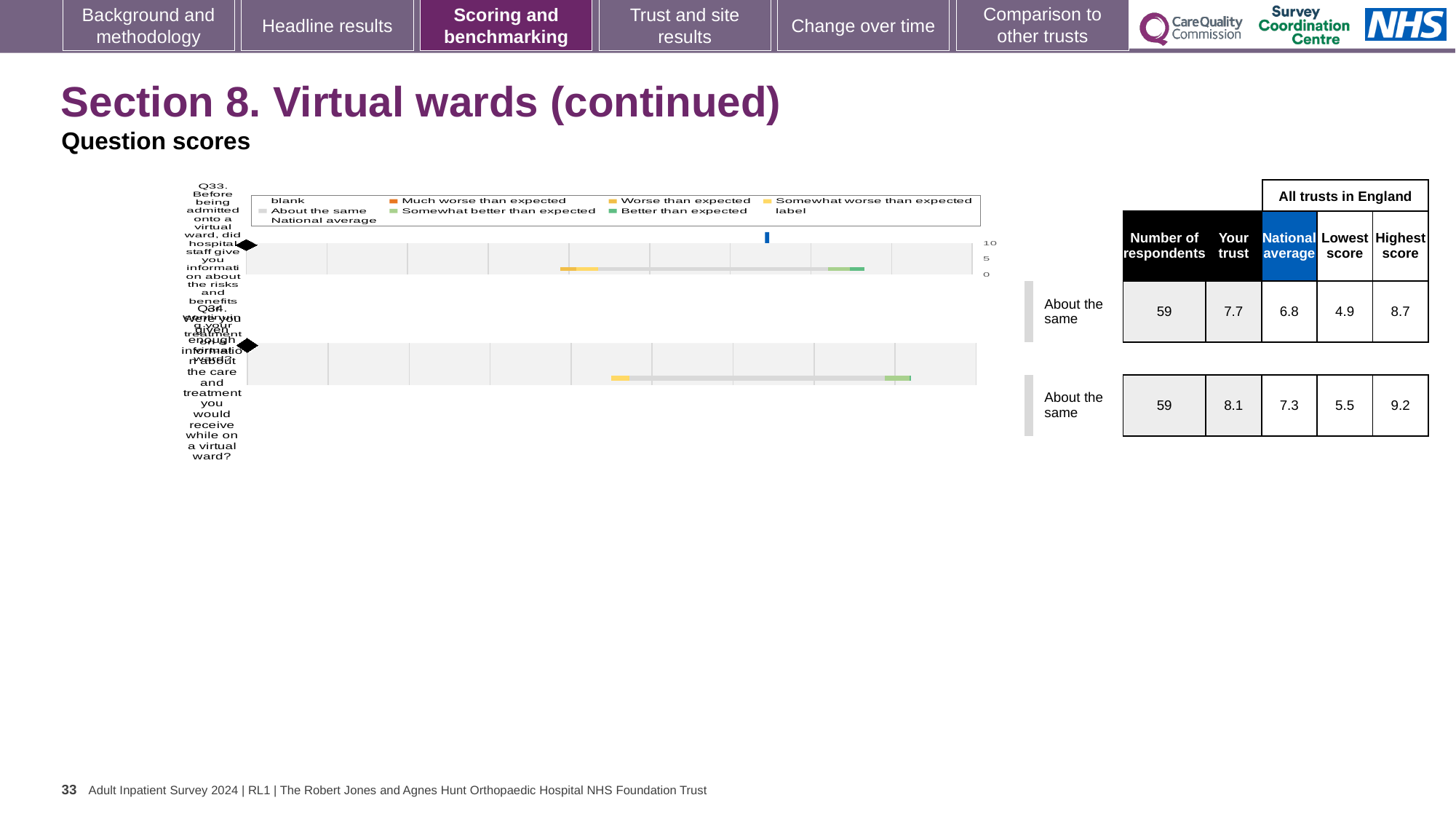
What is the difference between the trust's score and the national average for Q33? 0.9 What is the national average score for Q34 (enough information about care and treatment on a virtual ward)? 7.3 Which question has the higher 'Your trust' score, Q33 or Q34? Q34 What is the highest score among all trusts in England for Q34? 9.2 What kind of chart is used to show the question scores for Q33 and Q34? bar chart What benchmark category is shown for Q34? About the same How many respondents answered Q33? 59 What is the lowest score among all trusts in England for Q33? 4.9 What is the 'Your trust' score for Q33 (information about the risks and benefits of a virtual ward)? 7.7 How many questions are plotted in the chart? 2 Which legend entry is shown in orange? Much worse than expected What is the difference between the highest and lowest scores in England for Q34? 3.7